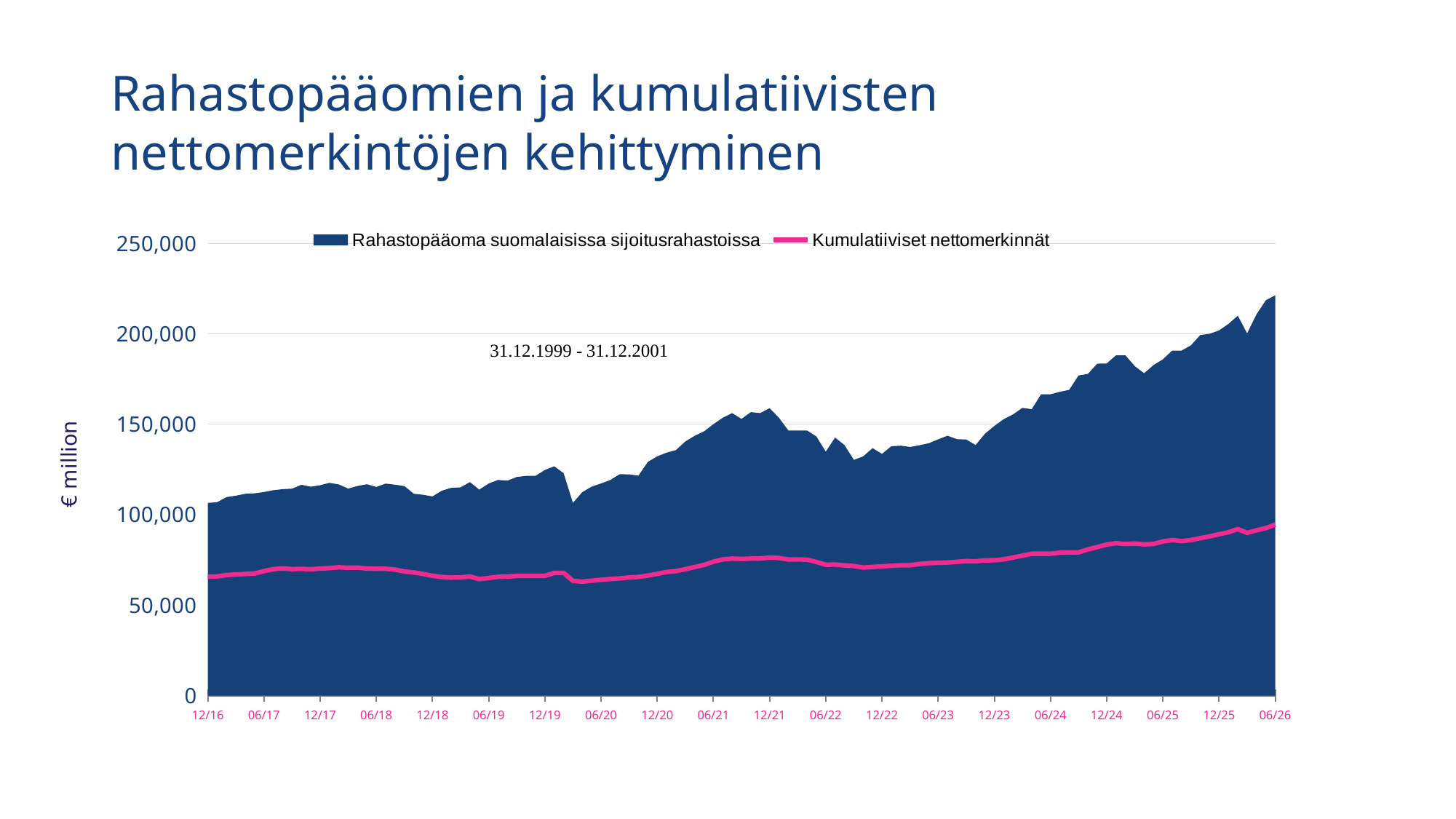
Is the value of Rahastopääoma suomalaisissa sijoitusrahastoissa at 06/26 greater or less than 200,000? greater Overall, do the values of Rahastopääoma suomalaisissa sijoitusrahastoissa rise or fall from 12/16 to 06/26? rise Is the value of Rahastopääoma suomalaisissa sijoitusrahastoissa at 12/22 greater or less than 150,000? less Which series has the higher value at 06/26, Rahastopääoma suomalaisissa sijoitusrahastoissa or Kumulatiiviset nettomerkinnät? Rahastopääoma suomalaisissa sijoitusrahastoissa Is the value of Kumulatiiviset nettomerkinnät at 12/16 greater or less than 50,000? greater How many series does the legend list? 2 What is the label on the vertical axis? € million At which x-axis date does Rahastopääoma suomalaisissa sijoitusrahastoissa reach its highest value? 06/26 What are the two series named in the legend? Rahastopääoma suomalaisissa sijoitusrahastoissa and Kumulatiiviset nettomerkinnät What kind of chart is shown on the slide? An area chart with a line series